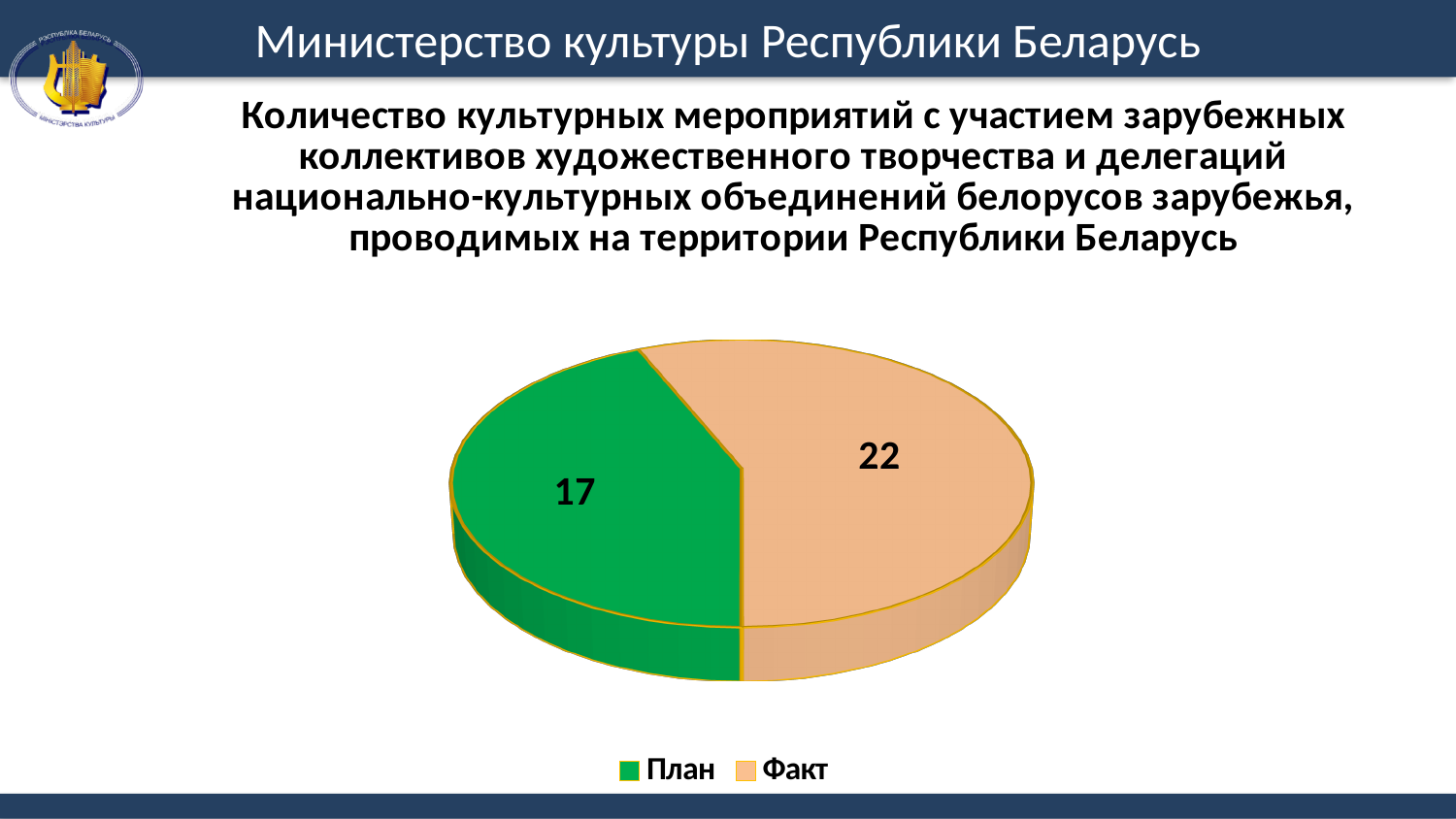
Which slice of the pie chart has the smaller value? План What is the total of the two values shown in the pie chart? 39 How many entries does the legend of the chart list? 2 What are the two legend entries of the chart? План and Факт Is the value for Факт larger or smaller than the value for План? larger What value is shown for the План slice of the pie chart? 17 What kind of chart is shown on the slide? pie chart What colour is the План slice in the pie chart? green By how much does the Факт value exceed the План value? 5 How many slices does the pie chart have? 2 What value is shown for the Факт slice of the pie chart? 22 Which slice of the pie chart has the larger value? Факт